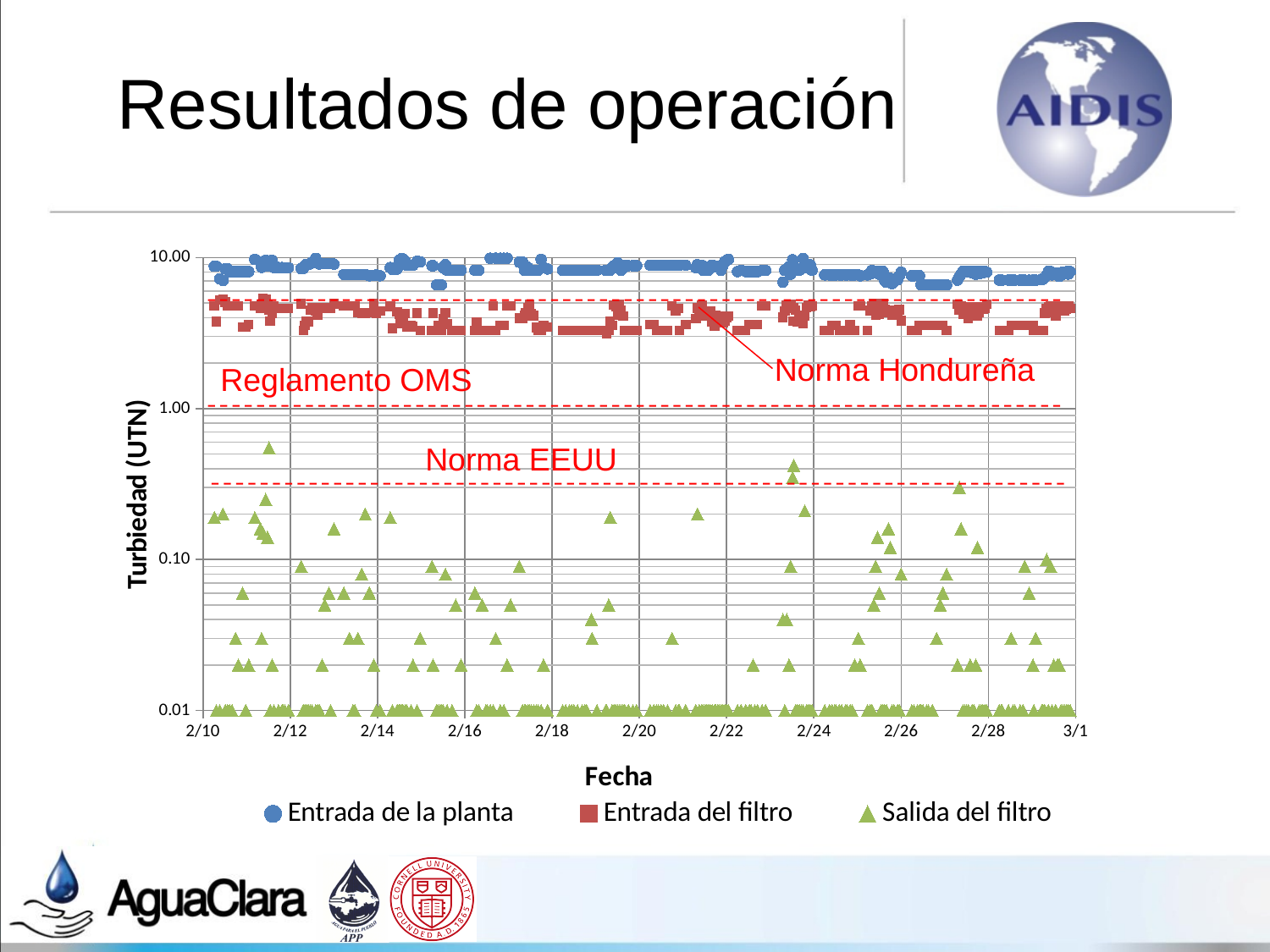
What is the label of the y axis? Turbiedad (UTN) Which series is plotted with green triangles? Salida del filtro Are the values for Entrada de la planta greater or less than 1.00 UTN? greater What is the first date shown on the x axis? 2/10 Which series has higher values: Entrada del filtro or Salida del filtro? Entrada del filtro Are the values for Salida del filtro greater or less than 1.00 UTN? less How many series does the chart legend list? 3 Are the values for Entrada del filtro greater or less than 10.00 UTN? less Which series has the highest turbidity values overall: Entrada de la planta, Entrada del filtro, or Salida del filtro? Entrada de la planta Which reference line is drawn at 1.00 UTN on the chart? Reglamento OMS Which series has the lowest turbidity values overall? Salida del filtro What kind of chart is shown on the slide? scatter chart